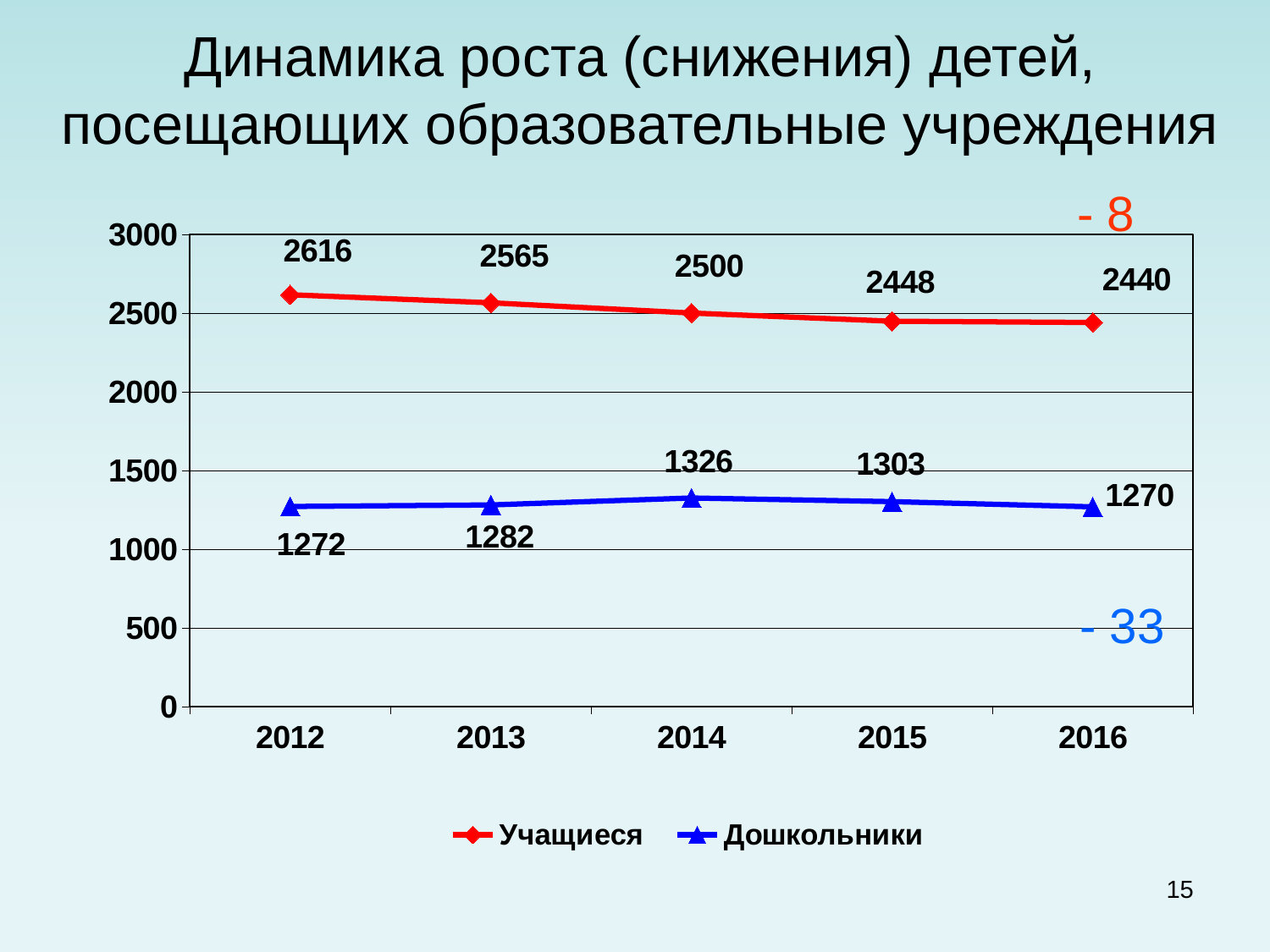
Is the value for Учащиеся in 2014 greater or less than 2000? greater What is the difference between the Учащиеся values in 2012 and 2016? 176 What is the value for Дошкольники in 2014? 1326 Which is larger, the Дошкольники value in 2013 or in 2015? 2015 How many years are shown on the x axis? 5 Does the Учащиеся series rise or fall from 2012 to 2016? fall What is the value for Учащиеся in 2016? 2440 In which year is the Учащиеся series lowest? 2016 How many series does the legend list? 2 What kind of chart is shown on the slide? line chart In which year is the Дошкольники series highest? 2014 What is the value for Учащиеся in 2012? 2616